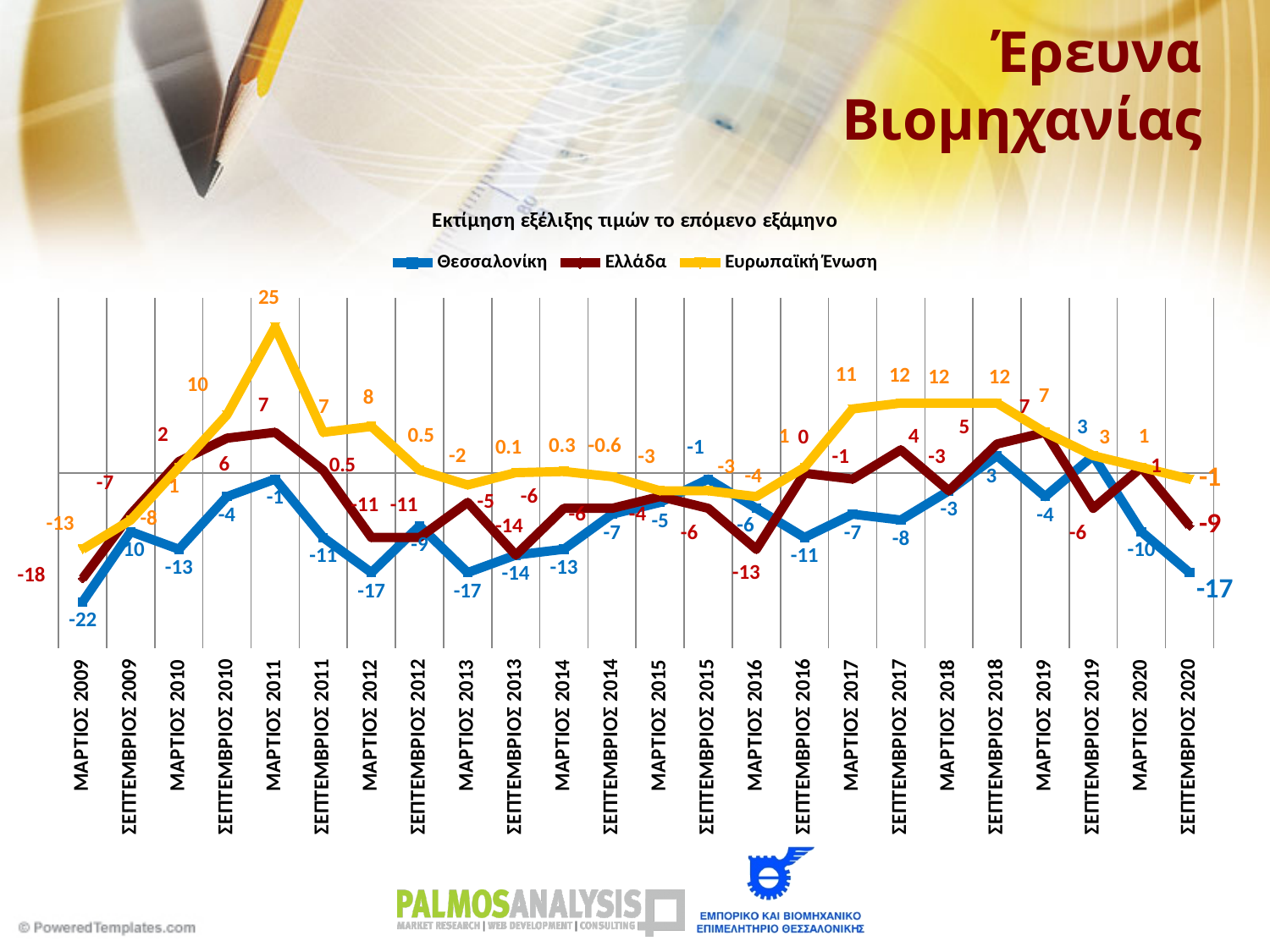
What is the title of the chart? Εκτίμηση εξέλιξης τιμών το επόμενο εξάμηνο What kind of chart is shown on the slide? line chart What is the value for Θεσσαλονίκη in ΣΕΠΤΕΜΒΡΙΟΣ 2020? -17 In ΜΑΡΤΙΟΣ 2011, which series has the higher value, Ευρωπαϊκή Ένωση or Ελλάδα? Ευρωπαϊκή Ένωση What is the difference between the Ελλάδα and Θεσσαλονίκη values in ΣΕΠΤΕΜΒΡΙΟΣ 2020? 8 What is the value for Ευρωπαϊκή Ένωση in ΜΑΡΤΙΟΣ 2011? 25 What is the value for Θεσσαλονίκη in ΜΑΡΤΙΟΣ 2009? -22 What is the value for Ελλάδα in ΣΕΠΤΕΜΒΡΙΟΣ 2020? -9 How many series does the legend list? 3 In which period does Ευρωπαϊκή Ένωση reach its highest value? ΜΑΡΤΙΟΣ 2011 How many time points are plotted along the x axis? 24 In which period does Θεσσαλονίκη have its lowest value? ΜΑΡΤΙΟΣ 2009